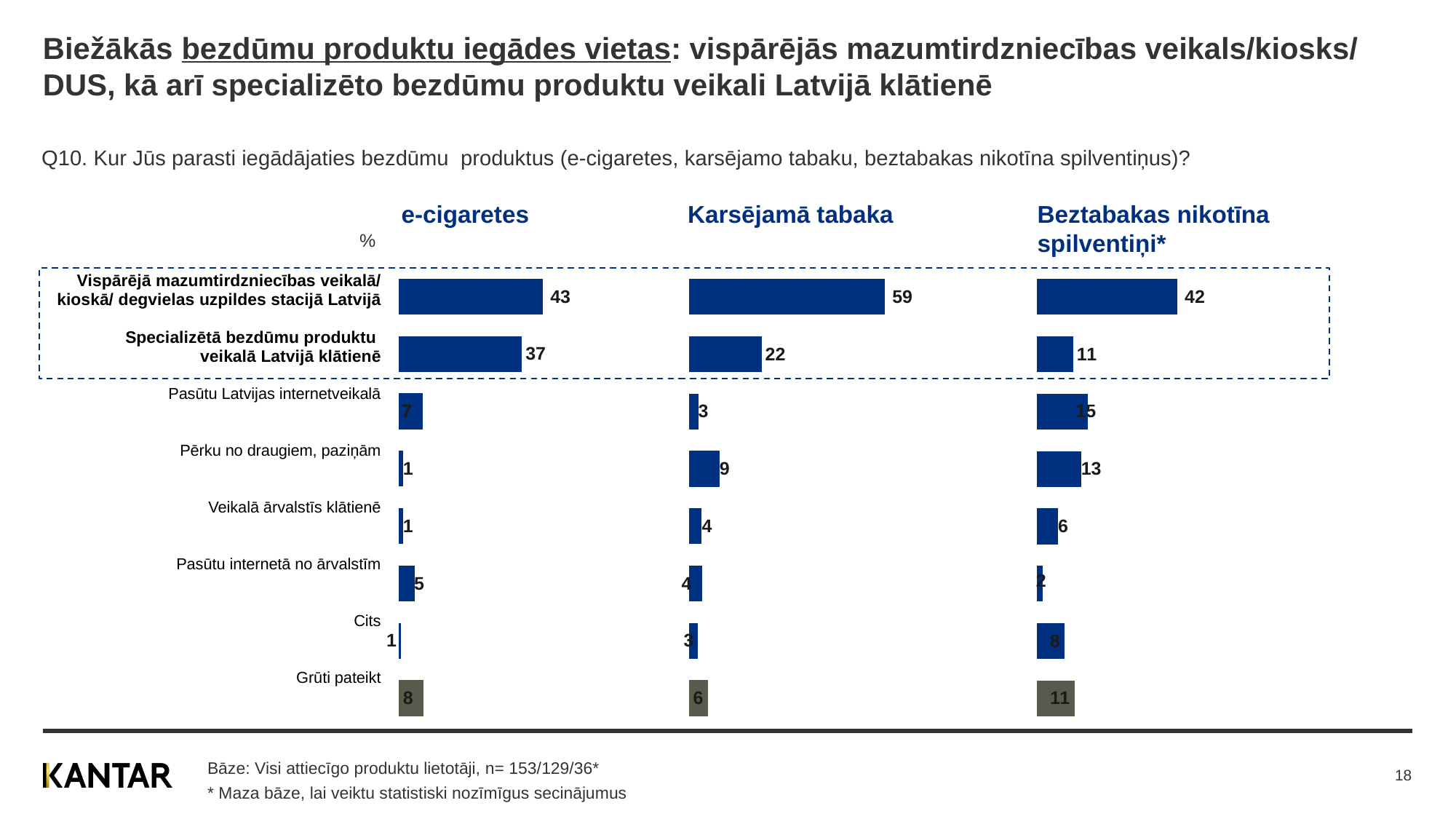
In the e-cigaretes chart, what is the difference between the values for Vispārējā mazumtirdzniecības veikalā/ kioskā/ degvielas uzpildes stacijā Latvijā and Specializētā bezdūmu produktu veikalā Latvijā klātienē? 6 In the Beztabakas nikotīna spilventiņi chart, what is the value for Pasūtu Latvijas internetveikalā? 15 In the Karsējamā tabaka chart, what is the value for Specializētā bezdūmu produktu veikalā Latvijā klātienē? 22 In the Karsējamā tabaka chart, which is larger: Pērku no draugiem, paziņām or Veikalā ārvalstīs klātienē? Pērku no draugiem, paziņām What kind of chart is used for Karsējamā tabaka? Bar chart How many categories are shown in the e-cigaretes chart? 8 In the Karsējamā tabaka chart, what is the difference between the values for Vispārējā mazumtirdzniecības veikalā/ kioskā/ degvielas uzpildes stacijā Latvijā and Specializētā bezdūmu produktu veikalā Latvijā klātienē? 37 In the Karsējamā tabaka chart, which category has the highest value? Vispārējā mazumtirdzniecības veikalā/ kioskā/ degvielas uzpildes stacijā Latvijā In the Beztabakas nikotīna spilventiņi chart, which category has the lowest value? Pasūtu internetā no ārvalstīm How many separate bar charts are shown on the slide? 3 In the e-cigaretes chart, what is the value for Vispārējā mazumtirdzniecības veikalā/ kioskā/ degvielas uzpildes stacijā Latvijā? 43 In the Beztabakas nikotīna spilventiņi chart, what is the value for Grūti pateikt? 11